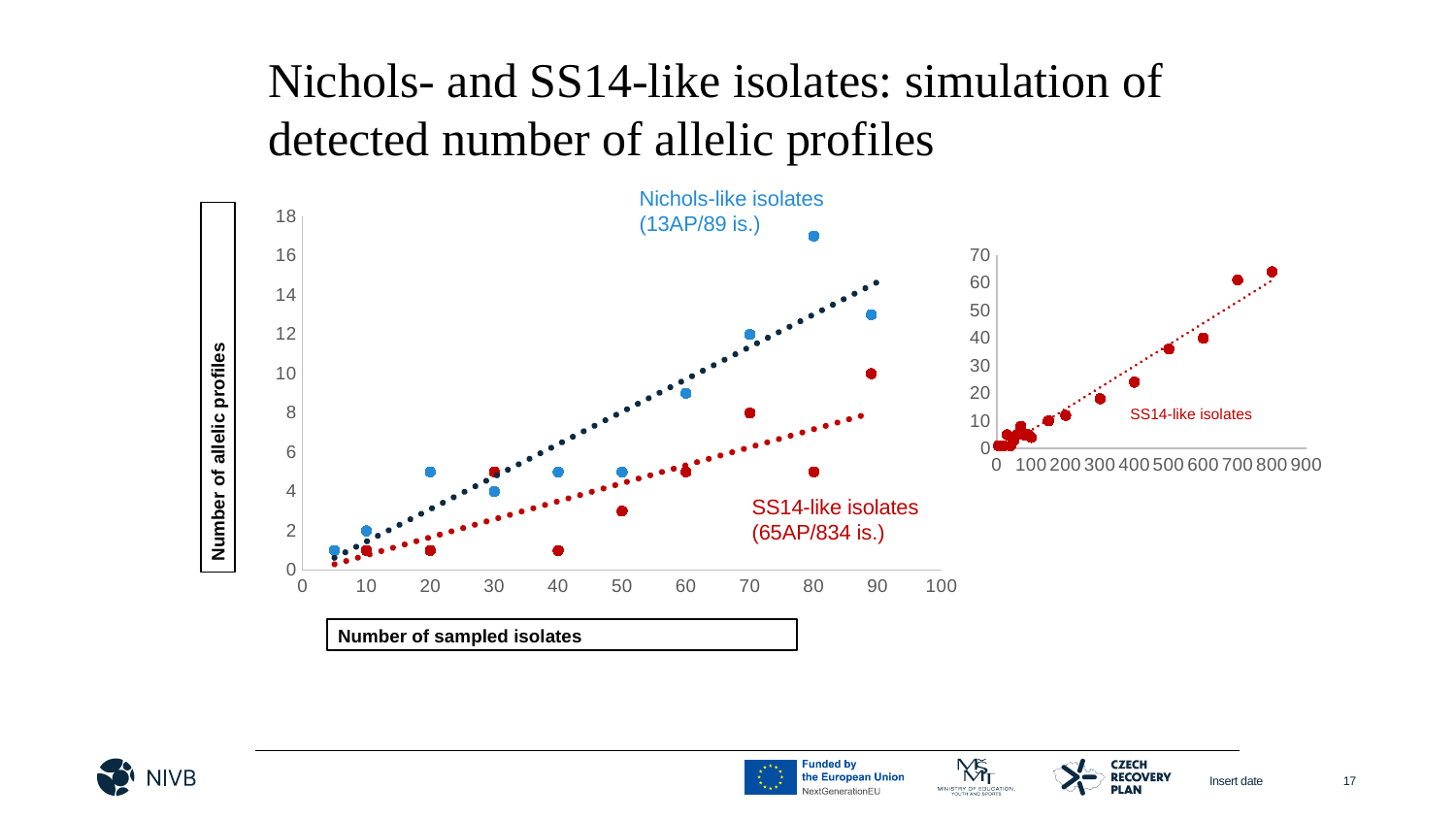
On the left chart, is the SS14-like isolates value at 40 sampled isolates greater or less than 2? less On the left chart, do the Nichols-like isolates values generally rise or fall as the number of sampled isolates increases? rise On the left chart, at 70 sampled isolates, which series has the higher number of allelic profiles, Nichols-like or SS14-like? Nichols-like isolates On the left chart, what is the label of the y axis? Number of allelic profiles On the left chart, what is the label of the x axis? Number of sampled isolates On the left chart, is the SS14-like isolates value at 90 sampled isolates greater or less than 8? greater On the left chart, at 80 sampled isolates, which series has the higher number of allelic profiles, Nichols-like or SS14-like? Nichols-like isolates On the left chart, is the Nichols-like isolates value at 80 sampled isolates greater or less than 16? greater On the left chart, at which number of sampled isolates does the Nichols-like series reach its highest point? 80 What kind of chart is the left chart on the slide? scatter chart